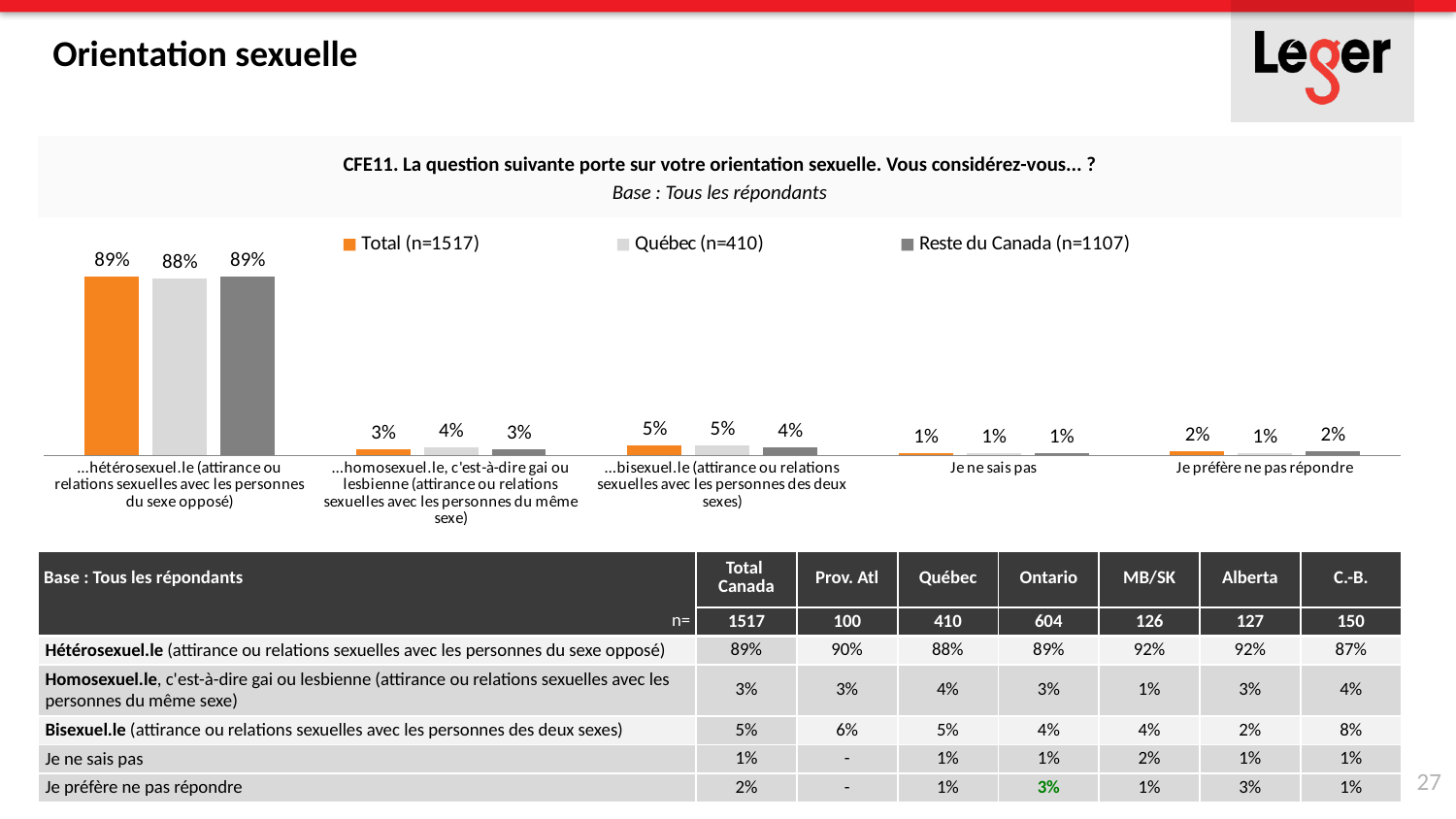
Which is larger: the Total (n=1517) value for "...bisexuel.le" or the Total (n=1517) value for "...homosexuel.le"? ...bisexuel.le What is the value for Québec (n=410) in the "...homosexuel.le" category? 4% What is the sample size shown in the legend for the Reste du Canada series? n=1107 What kind of chart is shown on the slide? Bar chart What is the difference between the Total (n=1517) value for "...hétérosexuel.le" and the Québec (n=410) value for the same category? 1% What is the value for Reste du Canada (n=1107) in the "Je préfère ne pas répondre" category? 2% Which category has the highest value for the Total (n=1517) series? ...hétérosexuel.le (attirance ou relations sexuelles avec les personnes du sexe opposé) What is the value for Total (n=1517) in the "...hétérosexuel.le" category? 89% How many series does the chart legend list? 3 What is the value for Québec (n=410) in the "...bisexuel.le" category? 5% How many categories are shown on the x axis of the chart? 5